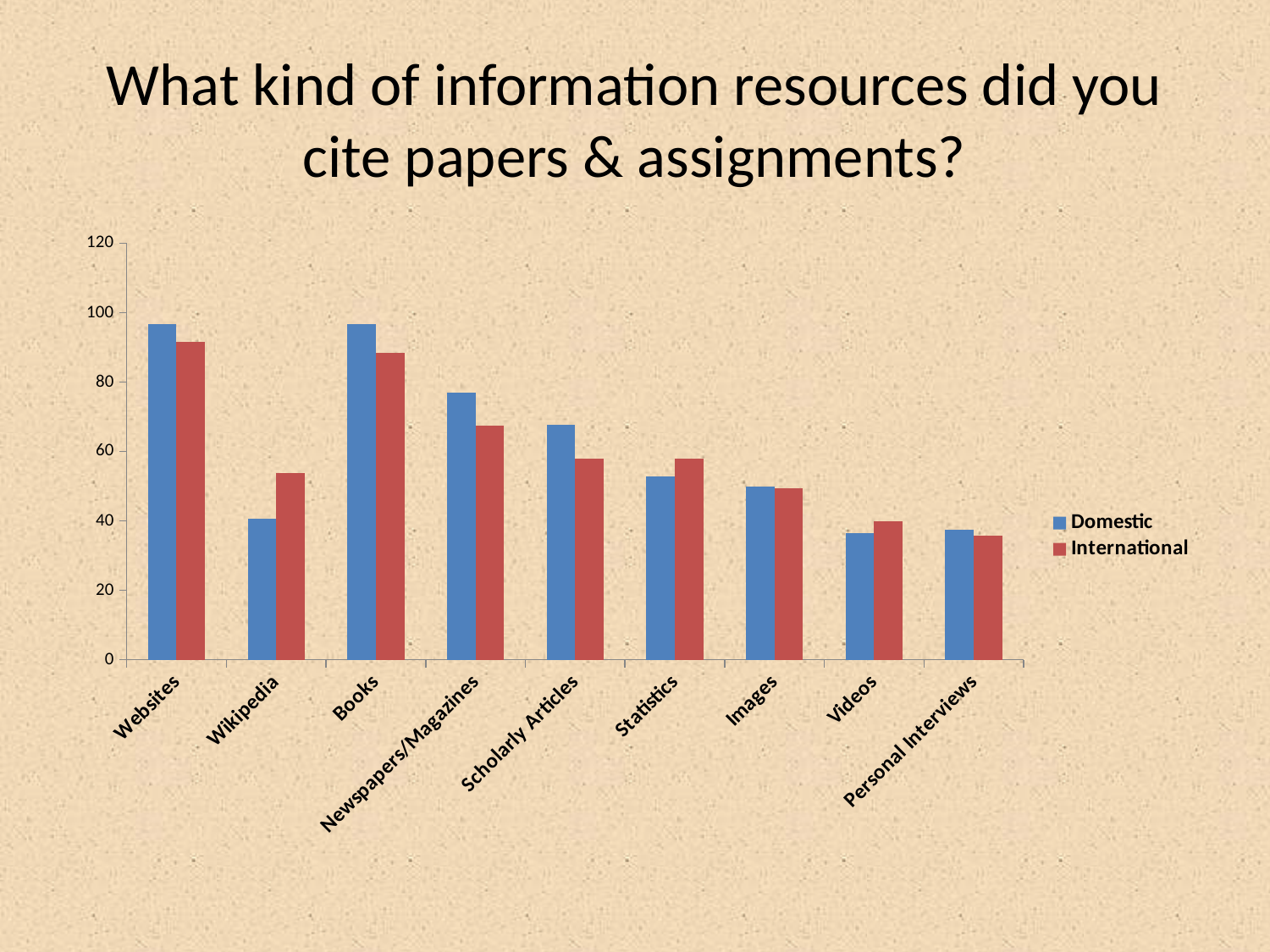
For Wikipedia, which is larger: the Domestic value or the International value? International Is the Domestic value for Websites greater or less than 80? greater For Newspapers/Magazines, which is larger: the Domestic value or the International value? Domestic How many categories are shown on the x axis of the chart? 9 What kind of chart is shown on the slide? bar chart Is the International value for Scholarly Articles greater or less than 80? less Is the Domestic value for Newspapers/Magazines greater or less than 60? greater Which two series are listed in the legend? Domestic and International How many series does the legend list? 2 For Books, which is larger: the Domestic value or the International value? Domestic